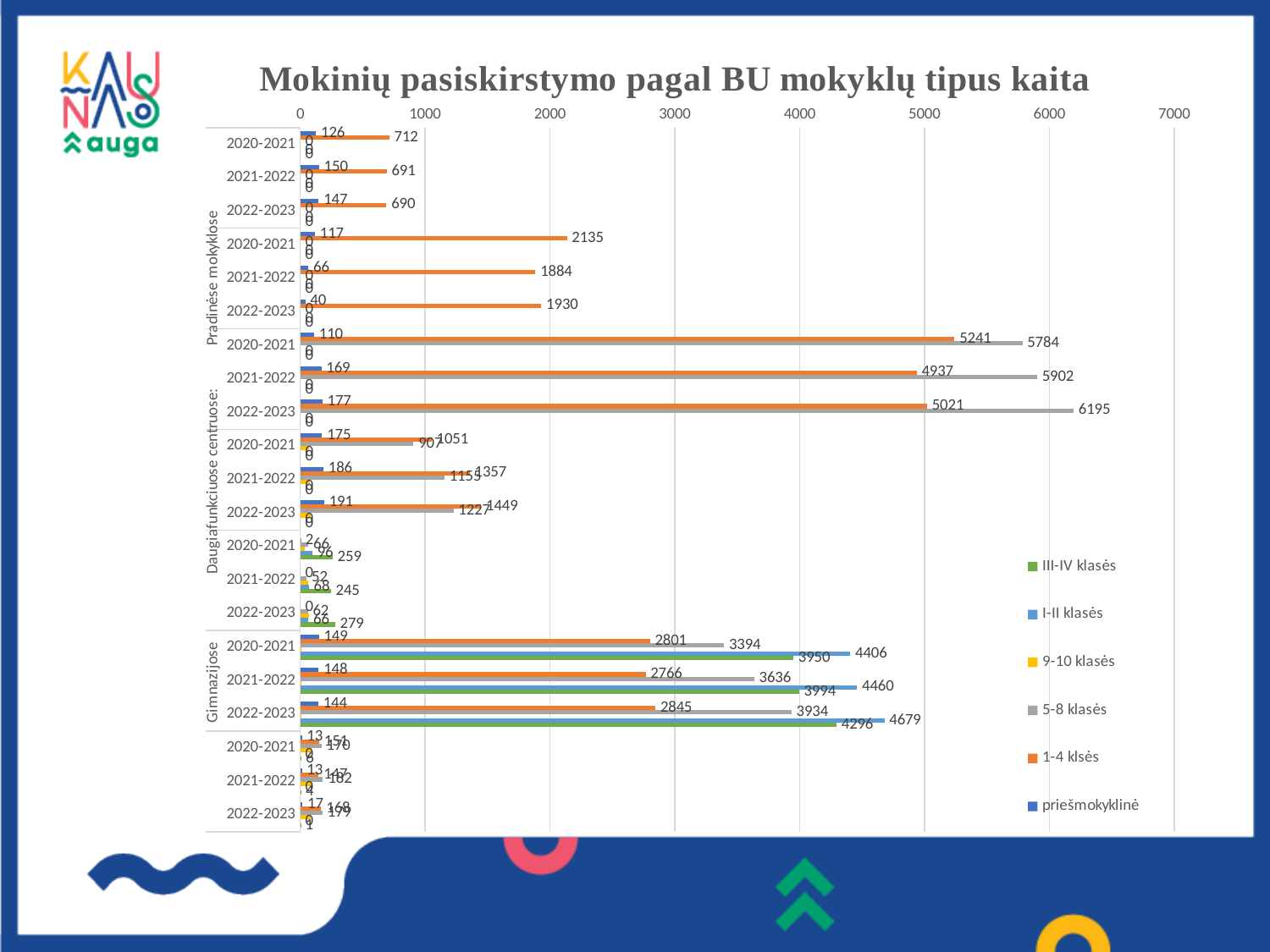
What is the largest value labeled anywhere on the chart? 6195 In the Gimnazijose group, what is the value for 5-8 klasės in 2021-2022? 3636 What type of chart is shown on the slide? bar chart In the Gimnazijose group, what is the value for 1-4 klsės in 2020-2021? 2801 In the Gimnazijose group, what is the difference between 5-8 klasės and 1-4 klsės in 2022-2023? 1089 What is the title of the chart? Mokinių pasiskirstymo pagal BU mokyklų tipus kaita In the Gimnazijose group, what is the value for priešmokyklinė in 2022-2023? 144 In the Gimnazijose group, what is the difference between the I-II klasės values for 2022-2023 and 2020-2021? 273 How many series does the legend list? 6 In the Gimnazijose group, do the I-II klasės values rise or fall from 2020-2021 to 2022-2023? rise In the Gimnazijose group, what is the value for I-II klasės in 2022-2023? 4679 In the Gimnazijose group for 2021-2022, which is larger: I-II klasės or III-IV klasės? I-II klasės